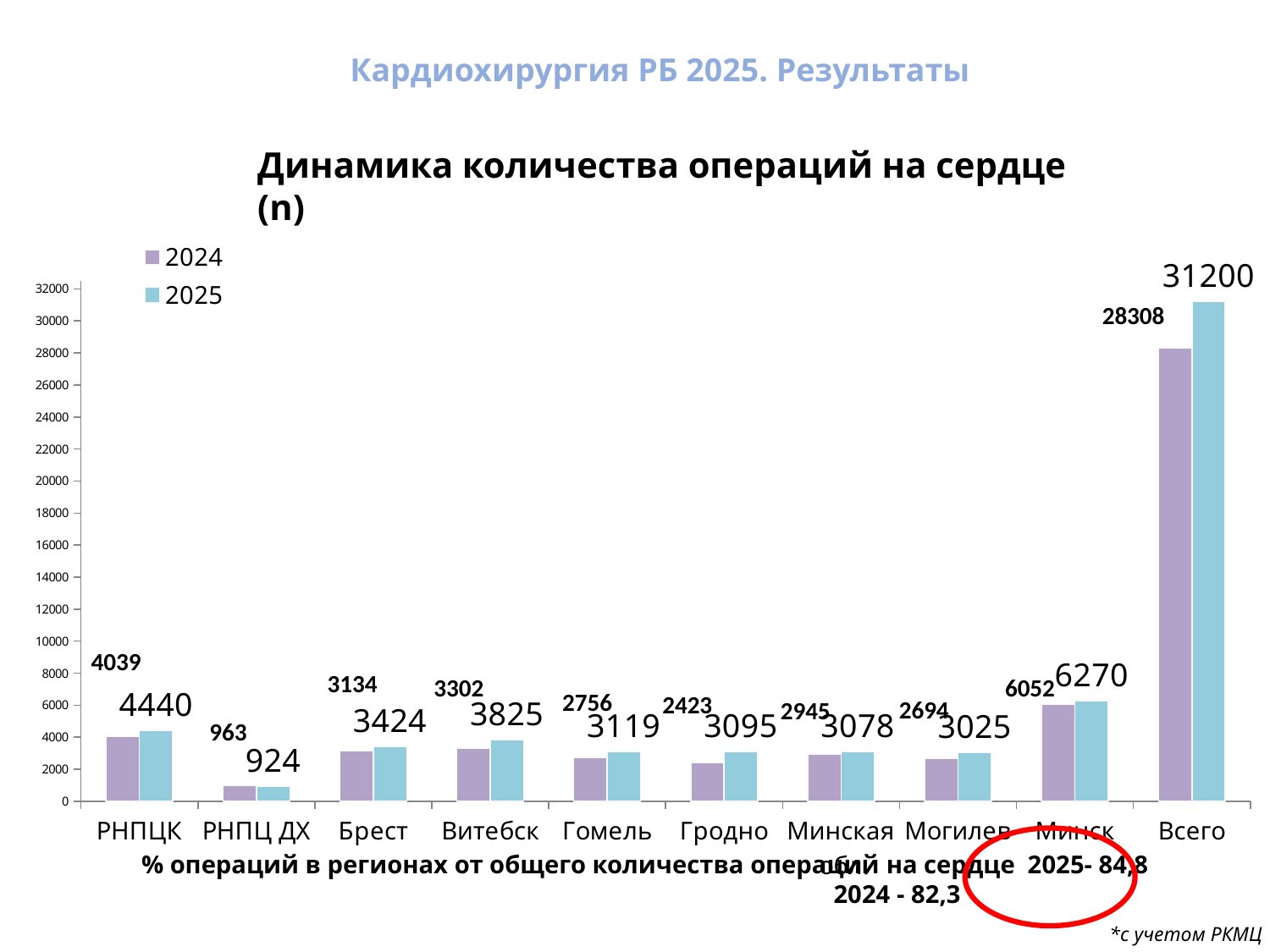
What is the 2024 value for РНПЦ ДХ? 963 Excluding Всего, which category has the highest 2025 value? Минск What is the 2025 value for Витебск? 3825 What is the title of the chart? Динамика количества операций на сердце (n) What is the difference between the 2025 and 2024 values for Всего? 2892 What is the 2025 value for Всего? 31200 How many series does the legend list? 2 Which category has the lowest 2024 value? РНПЦ ДХ What is the 2024 value for Минск? 6052 How many categories are shown on the x axis? 10 Which is larger for РНПЦ ДХ, the 2024 value or the 2025 value? 2024 What kind of chart is shown? bar chart